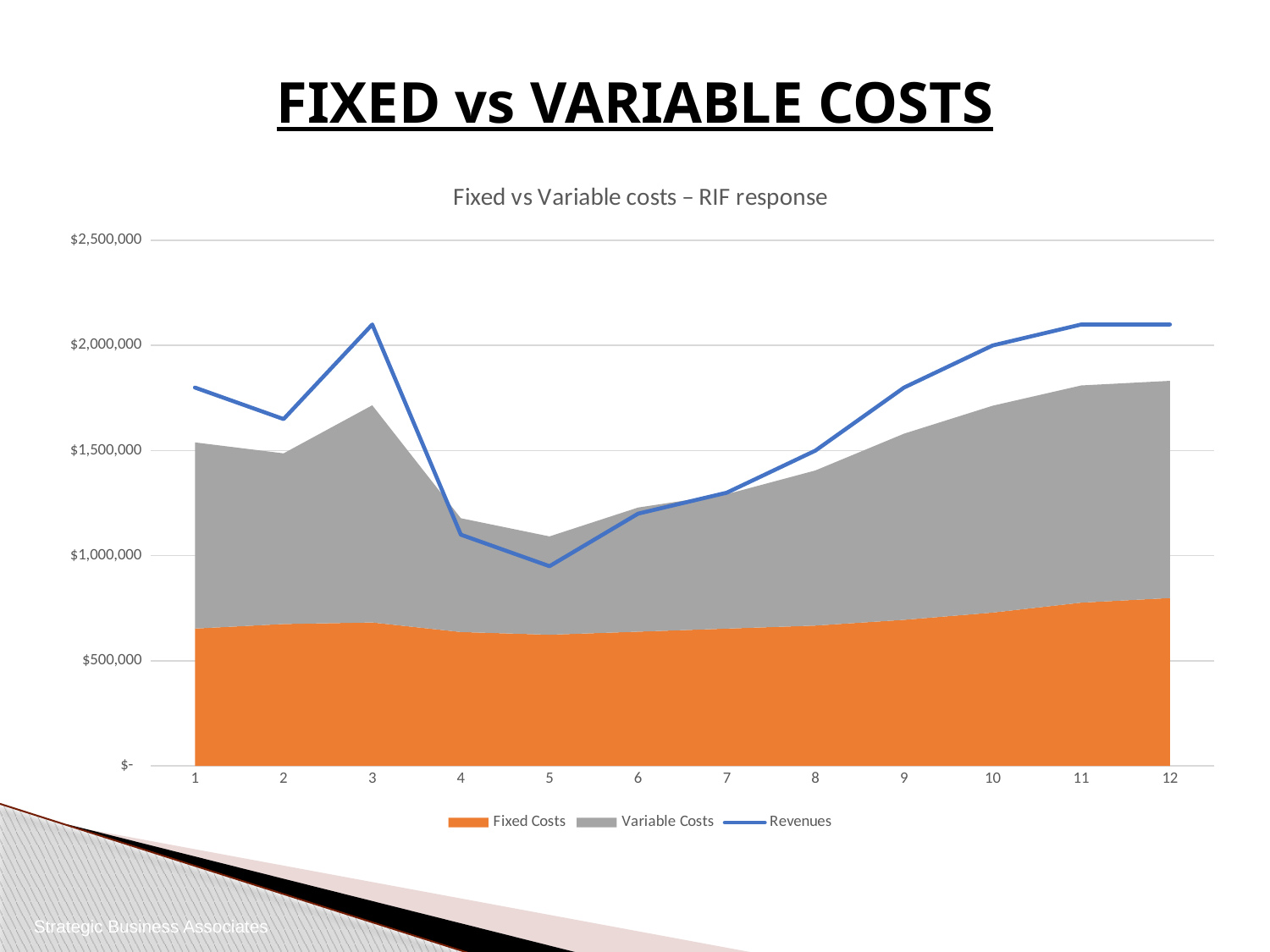
Which colour represents Fixed Costs in the chart? Orange Is the Fixed Costs value at point 1 greater or less than $500,000? greater Is the Revenues value at point 3 greater or less than $2,000,000? greater Which is larger, Revenues at point 3 or Revenues at point 1? Point 3 Do Revenues rise or fall from point 5 to point 12? Rise What kind of chart is this? Stacked area chart with a line series At which point on the x axis is Fixed Costs highest? 12 What is the title of the chart? Fixed vs Variable costs – RIF response How many series does the chart legend list? 3 How many points are plotted along the x axis? 12 At which point on the x axis is Revenues lowest? 5 Is the Revenues value at point 5 greater or less than $1,000,000? less